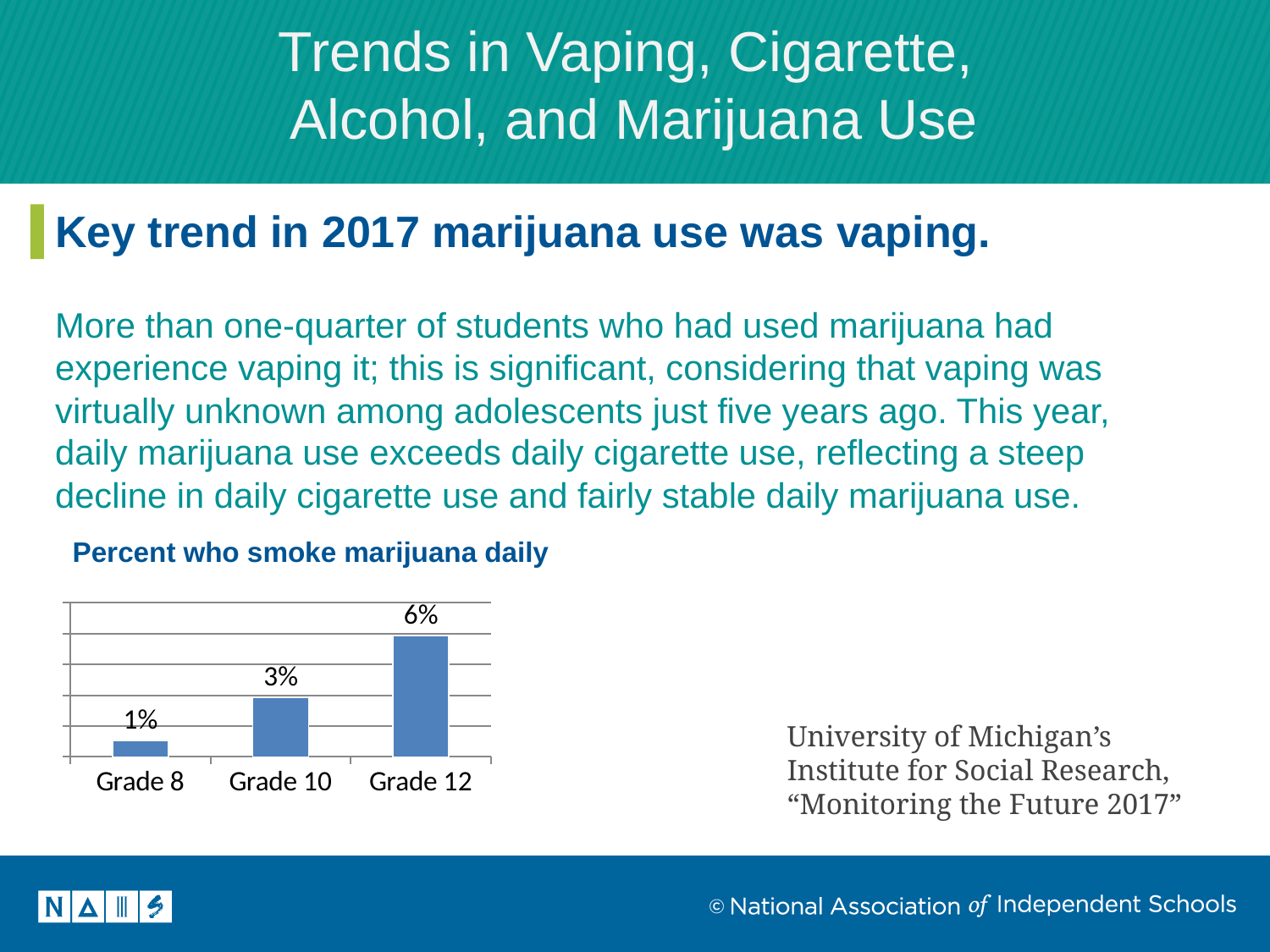
Do the values rise or fall from Grade 8 to Grade 12? Rise What is the difference between the values for Grade 12 and Grade 10? 3% What is the value for Grade 10 in the chart? 3% Which grade has the highest percent who smoke marijuana daily? Grade 12 What is the value for Grade 12 in the chart? 6% Which grade has the lowest percent who smoke marijuana daily? Grade 8 What is the difference between the values for Grade 10 and Grade 8? 2% Which is larger, the value for Grade 10 or the value for Grade 8? Grade 10 What kind of chart is shown on the slide? Bar chart What is the value for Grade 8 in the chart? 1% What is the title of the chart? Percent who smoke marijuana daily How many grade categories are shown in the chart? 3